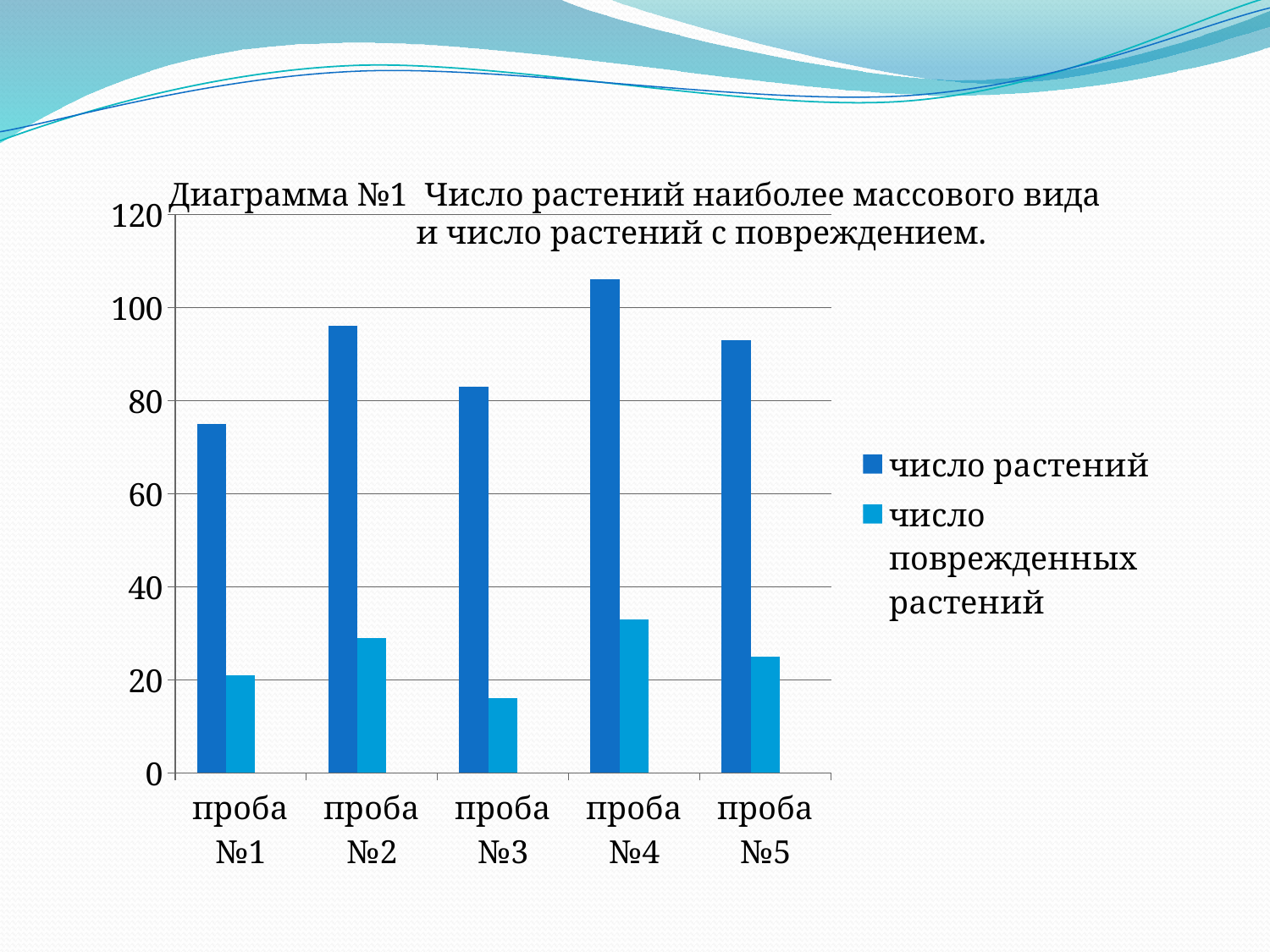
How many categories (пробы) are shown on the x axis? 5 How many series does the legend list? 2 What is the title of the chart? Диаграмма №1 Число растений наиболее массового вида и число растений с повреждением. Is the value of число поврежденных растений for проба №3 greater or less than 20? less Which проба has the highest value for число растений? проба №4 Is the value of число растений for проба №4 greater or less than 100? greater Is the value of число растений for проба №1 greater or less than 80? less Which is larger: число растений for проба №2 or for проба №3? проба №2 Which проба has the lowest value for число поврежденных растений? проба №3 Which проба has the highest value for число поврежденных растений? проба №4 Which проба has the lowest value for число растений? проба №1 What kind of chart is shown on the slide? bar chart